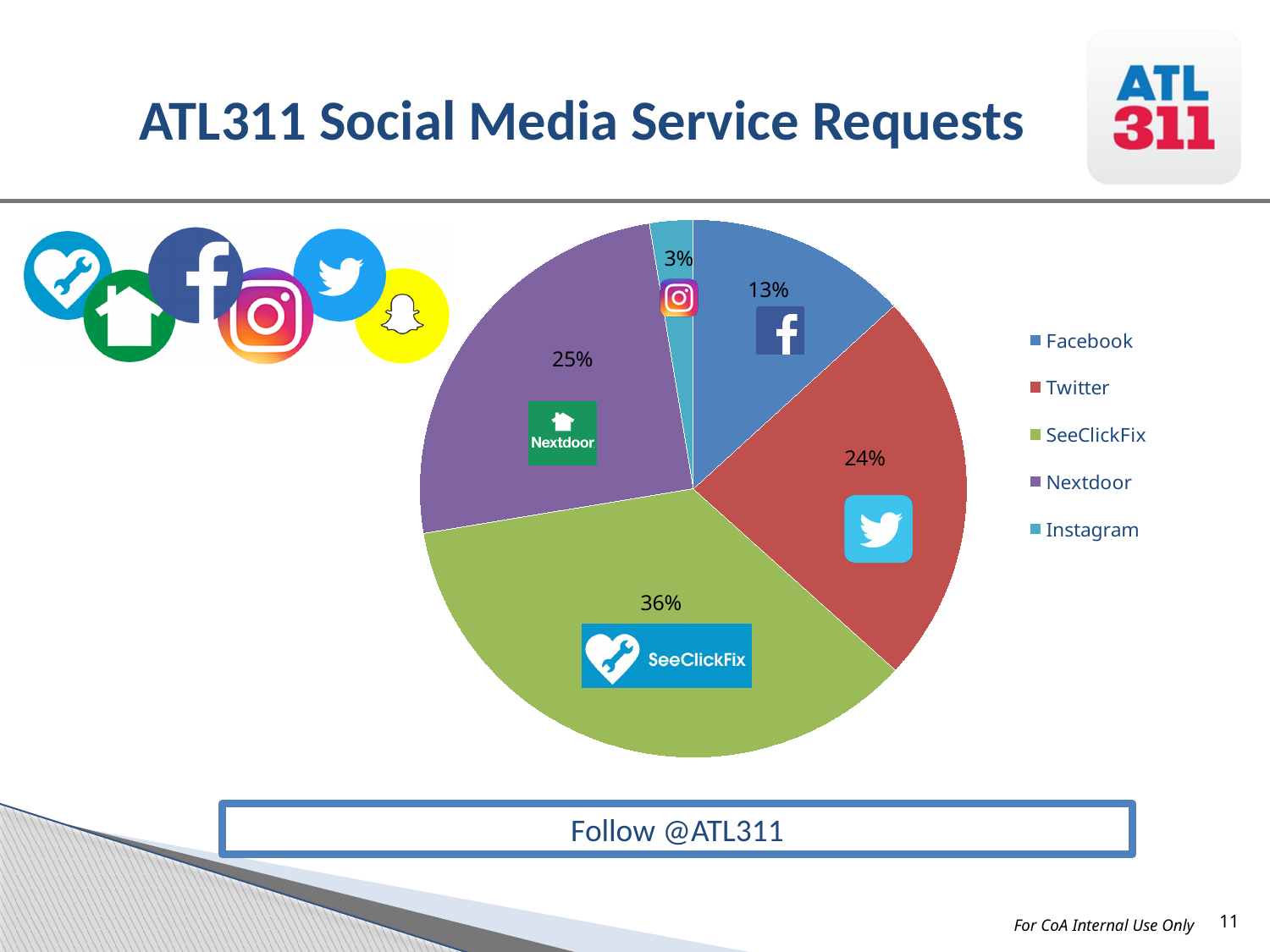
What colour is the Nextdoor slice in the pie chart? Purple What share of social media service requests came from SeeClickFix? 36% How many percentage points larger is the SeeClickFix share than the Facebook share? 23 How many platforms are shown in the pie chart? 5 What share of social media service requests came from Nextdoor? 25% What type of chart is used on this slide? Pie chart Which has a larger share of requests, Twitter or Facebook? Twitter What share of social media service requests came from Instagram? 3% What share of social media service requests came from Facebook? 13% What share of social media service requests came from Twitter? 24% Which platform accounts for the largest share of social media service requests? SeeClickFix Which platform accounts for the smallest share of social media service requests? Instagram